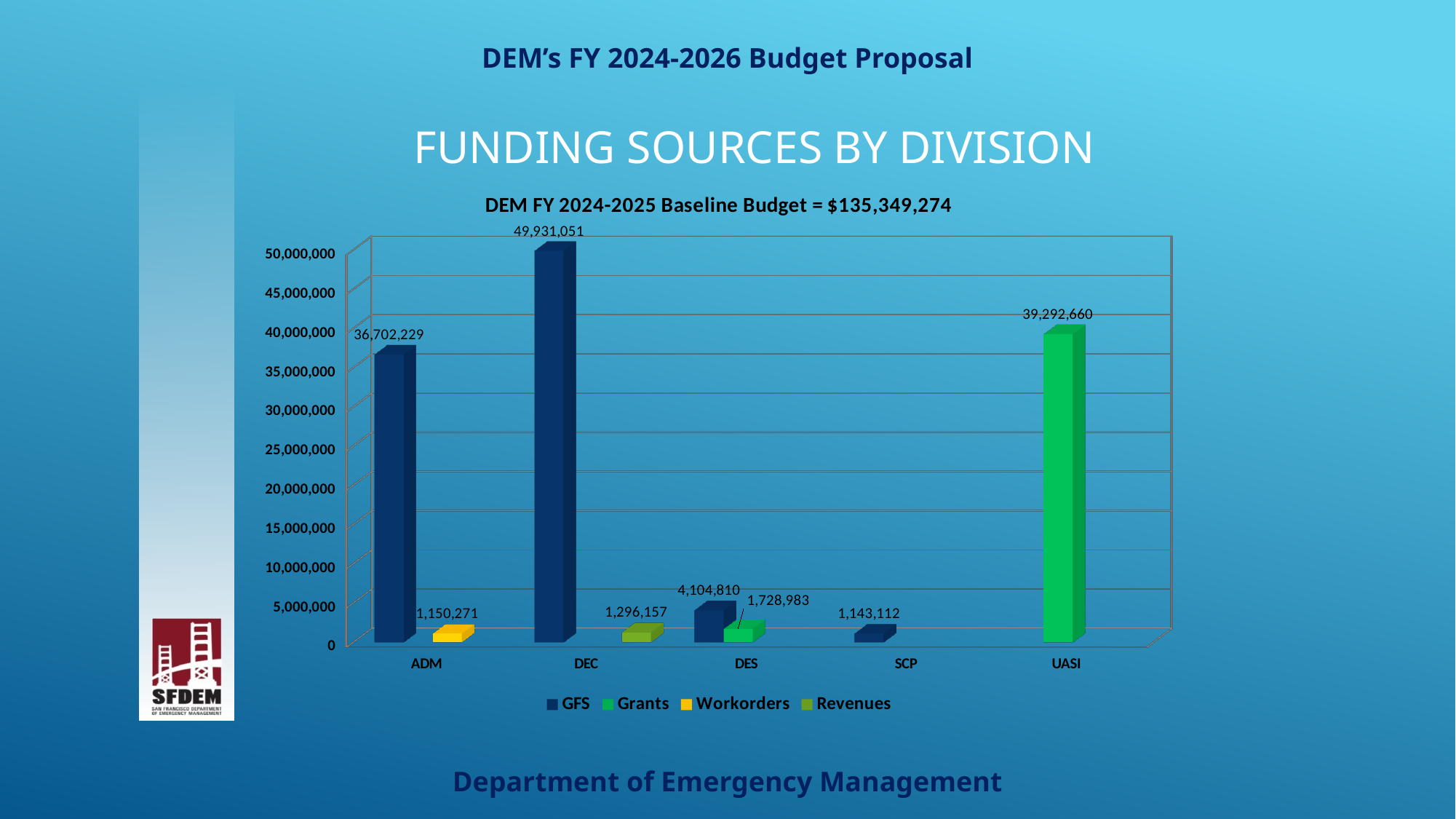
What is the difference between the GFS values for DEC and ADM? 13,228,822 What is the Grants value for UASI? 39,292,660 How many divisions are shown on the x axis? 5 What is the Workorders value for ADM? 1,150,271 What kind of chart is shown on the slide? Bar chart What is the GFS value for SCP? 1,143,112 Which division has the highest GFS value? DEC Which is larger: the GFS value for ADM or the Grants value for UASI? Grants value for UASI Which division has the lowest GFS value? SCP What is the GFS value for DEC? 49,931,051 What is the Revenues value for DEC? 1,296,157 How many series does the legend list? 4